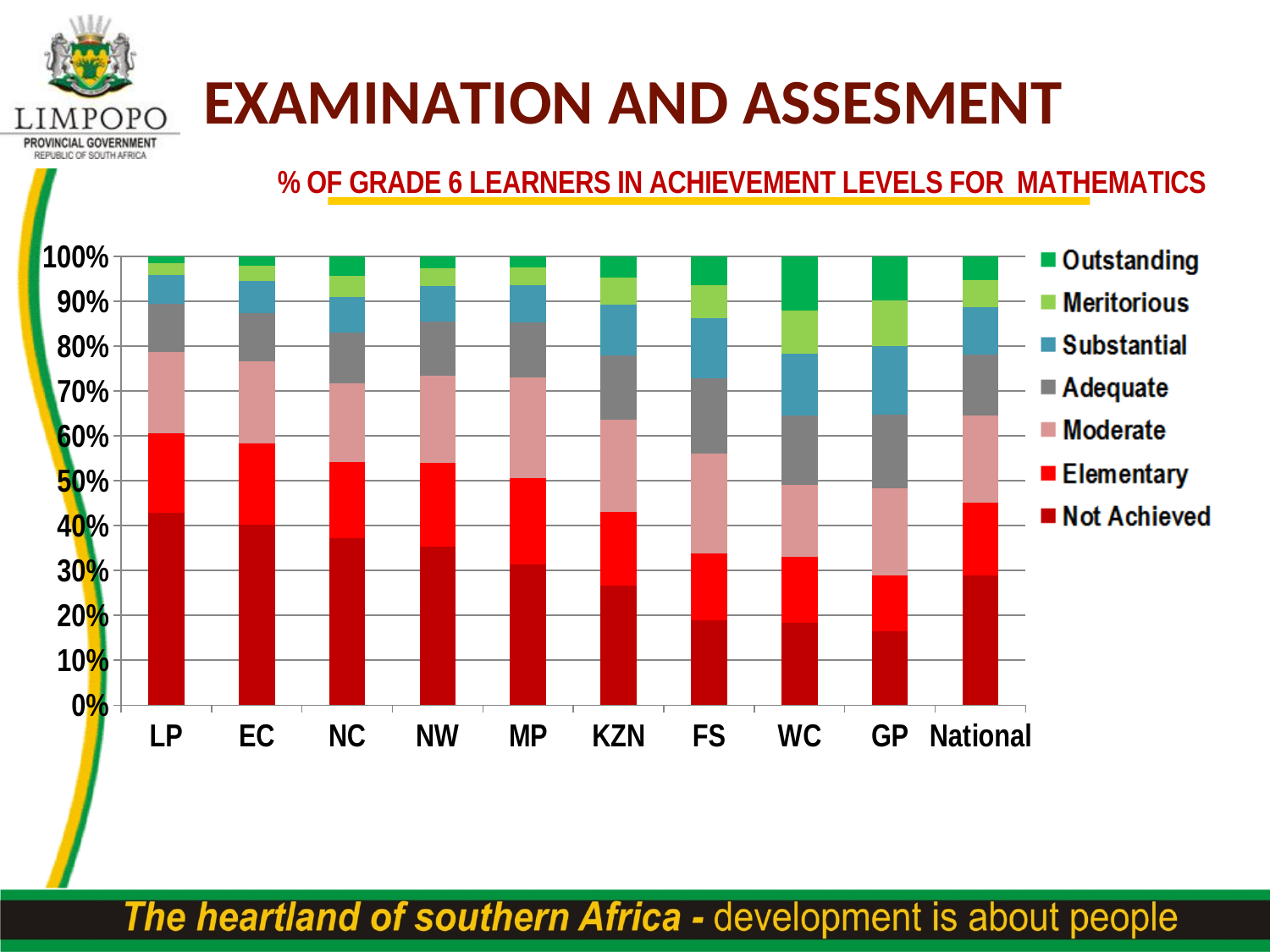
How many series does the chart's legend list? 7 Is the Not Achieved value for GP greater or less than 20%? less Is the Not Achieved value for NC greater or less than 40%? less Is the Not Achieved value for KZN greater or less than 30%? less Which series is shown at the bottom of each stacked bar? Not Achieved What is the title of the chart? % OF GRADE 6 LEARNERS IN ACHIEVEMENT LEVELS FOR MATHEMATICS What kind of chart is shown on the slide? Stacked bar chart How many categories are shown along the x axis of the chart? 10 Which has the larger Not Achieved share, NC or KZN? NC Does the Not Achieved share rise or fall across the provinces from LP to GP? Fall Which province has the highest Not Achieved share? LP